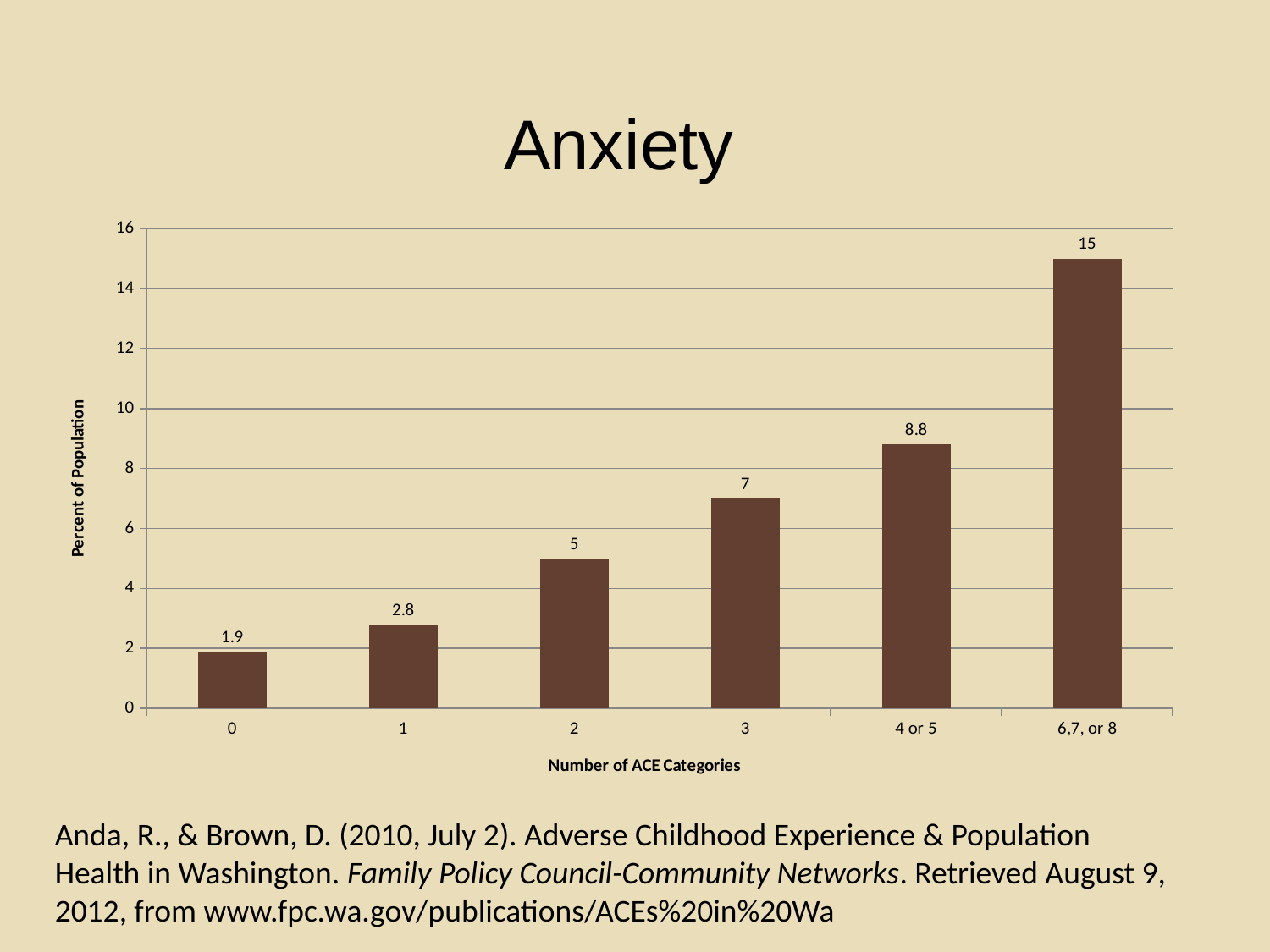
Do the values rise or fall as the number of ACE categories increases? Rise What is the percent of population with anxiety for 0 ACE categories? 1.9 What is the value for the '6,7, or 8' ACE categories bar? 15 What is the value for the '4 or 5' ACE categories bar? 8.8 What is the value for 2 ACE categories? 5 What is the difference between the values for 3 and 1 ACE categories? 4.2 Which is larger, the value for 2 ACE categories or the value for 3 ACE categories? 3 Which number of ACE categories has the lowest percent of population? 0 What type of chart is shown on the slide? Bar chart How many bars are shown in the chart? 6 Which number of ACE categories has the highest percent of population? 6,7, or 8 What is the difference between the values for '6,7, or 8' and '4 or 5' ACE categories? 6.2